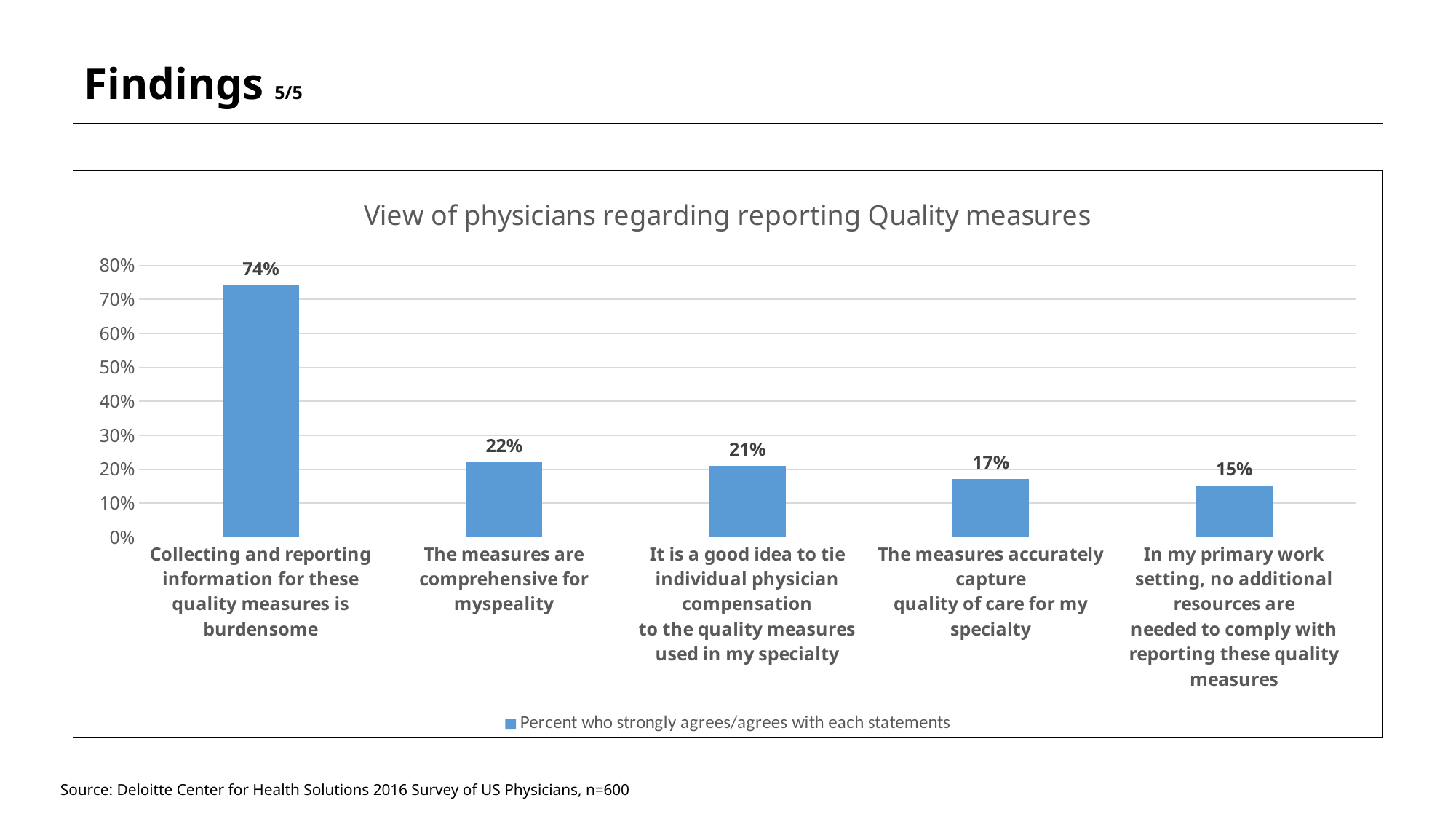
What percentage of physicians agree that the measures accurately capture quality of care for their specialty? 17% What percentage of physicians agree that collecting and reporting information for these quality measures is burdensome? 74% What percentage of physicians agree that it is a good idea to tie individual physician compensation to the quality measures used in their specialty? 21% What percentage of physicians agree that no additional resources are needed in their primary work setting to comply with reporting these quality measures? 15% Which statement has the lowest percentage of physicians agreeing with it? In my primary work setting, no additional resources are needed to comply with reporting these quality measures Which statement has the highest percentage of physicians agreeing with it? Collecting and reporting information for these quality measures is burdensome What is the title of the chart? View of physicians regarding reporting Quality measures Which has a higher percentage: the statement that measures accurately capture quality of care, or the statement that no additional resources are needed? The measures accurately capture quality of care for my specialty How many statements are shown on the chart? 5 What percentage of physicians agree that the measures are comprehensive for their specialty? 22% What type of chart is shown on the slide? Bar chart What is the difference in percentage points between the statement about measures being burdensome and the statement about measures being comprehensive? 52